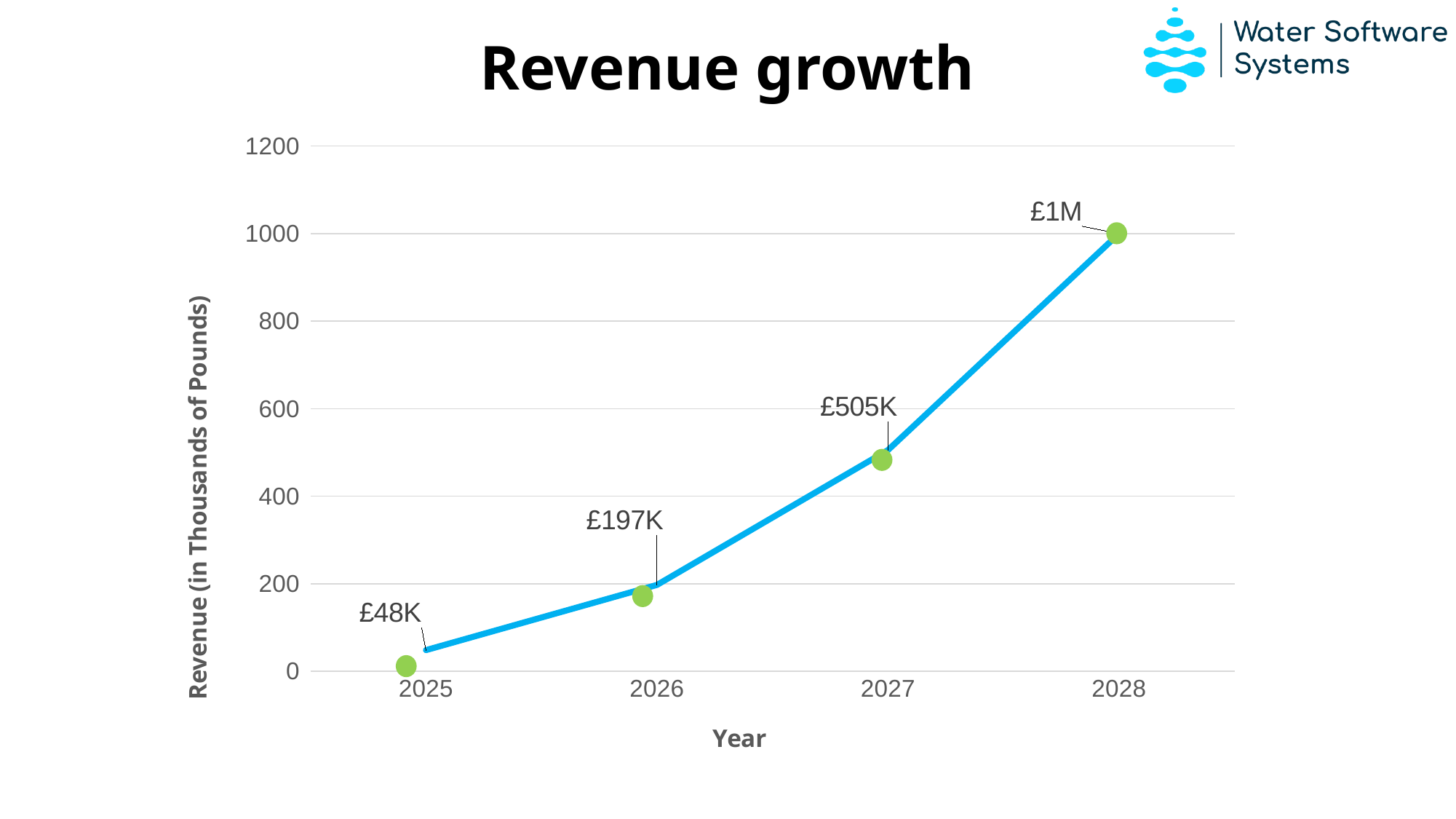
What is the revenue value shown for 2025? £48K What is the difference between the revenue for 2027 and the revenue for 2026? £308K Do the revenue values rise or fall from 2025 to 2028? Rise Which year has the highest revenue? 2028 How many years are plotted on the chart? 4 What is the revenue value shown for 2027? £505K Which year has the lowest revenue? 2025 Is the value for 2025 greater or less than 200? less What is the revenue value shown for 2026? £197K Which is larger, the revenue for 2026 or the revenue for 2027? 2027 What is the revenue value shown for 2028? £1M What kind of chart is shown on the slide? Line chart